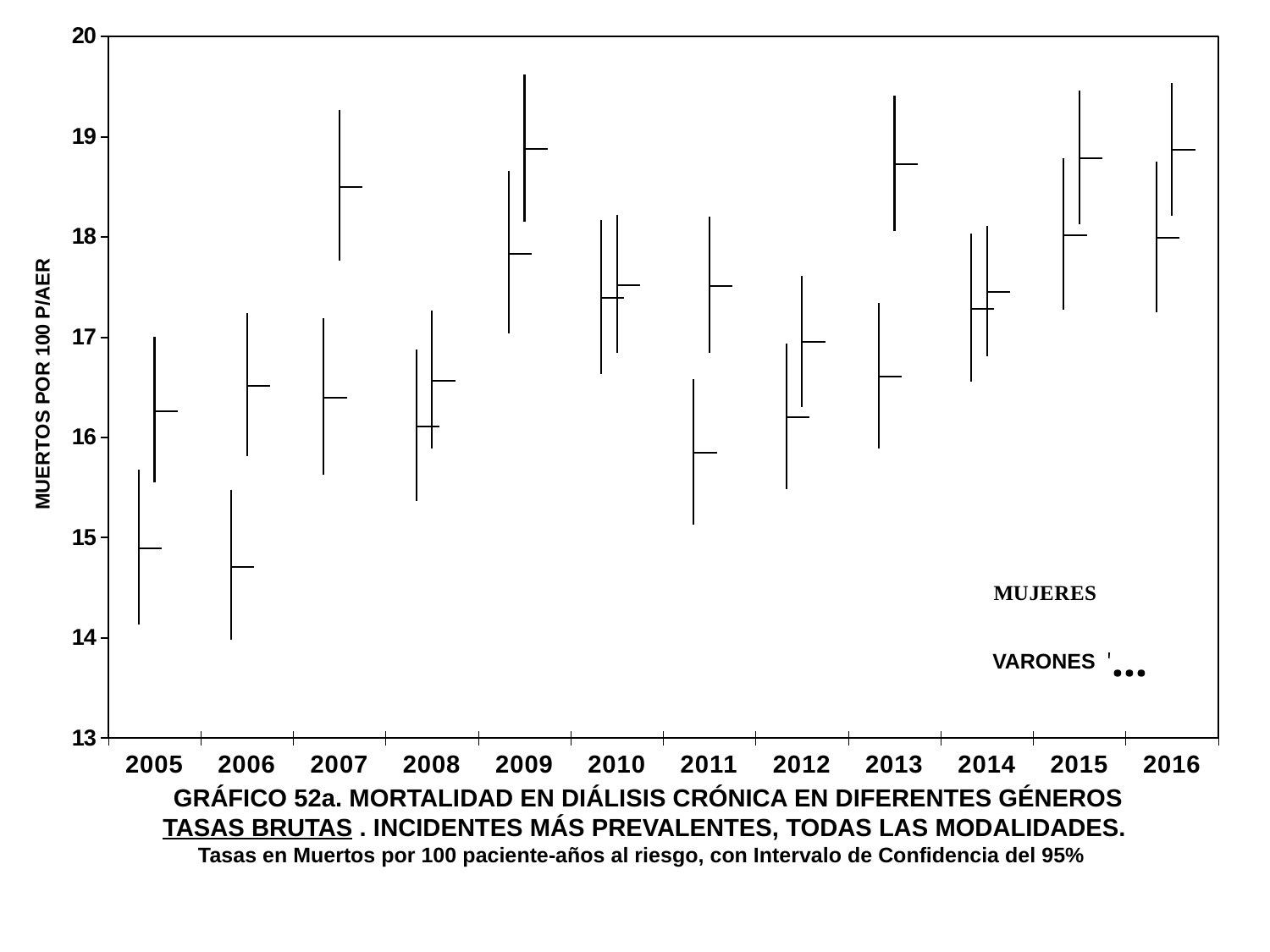
In 2006, which of the two intervals has the higher central value, the left-hand one or the right-hand one? the right-hand one Is the central value of the right-hand interval for 2013 greater or less than 18? greater Is the central value of the left-hand interval for 2011 greater or less than 16? less What are the two series named in the chart's legend? MUJERES and VARONES What is the label of the chart's y axis? MUERTOS POR 100 P/AER Do the central values of the right-hand intervals generally rise or fall from 2005 to 2016? rise Is the central value of the left-hand interval for 2005 greater or less than 15? less What kind of chart is shown on the slide? error bar (confidence interval) chart How many years are shown along the x axis of the chart? 12 How many series does the chart's legend list? 2